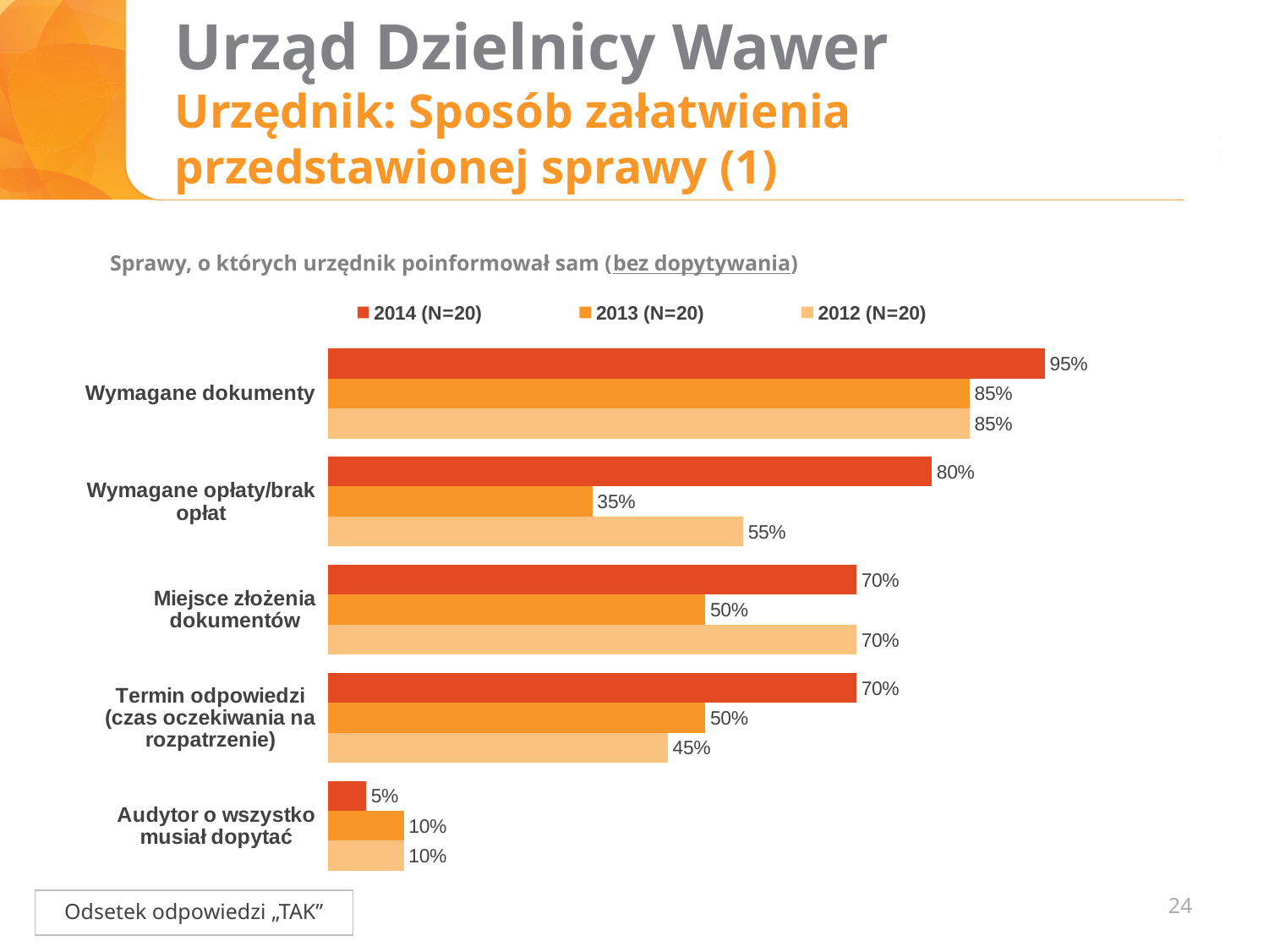
How many series does the legend list? 3 What is the value for 'Wymagane opłaty/brak opłat' in the 2013 (N=20) series? 35% What is the value for 'Termin odpowiedzi (czas oczekiwania na rozpatrzenie)' in the 2012 (N=20) series? 45% What are the three series listed in the legend? 2014 (N=20), 2013 (N=20), 2012 (N=20) What is the value for 'Audytor o wszystko musiał dopytać' in the 2014 (N=20) series? 5% What is the difference between the 2014 (N=20) and 2013 (N=20) values for 'Wymagane opłaty/brak opłat'? 45% What kind of chart is shown on the slide? Bar chart Which category has the lowest value in the 2013 (N=20) series? Audytor o wszystko musiał dopytać How many categories are shown on the chart? 5 Which is larger for 'Miejsce złożenia dokumentów': the 2013 (N=20) value or the 2012 (N=20) value? 2012 (N=20) What is the value for 'Wymagane dokumenty' in the 2014 (N=20) series? 95% Which category has the highest value in the 2014 (N=20) series? Wymagane dokumenty